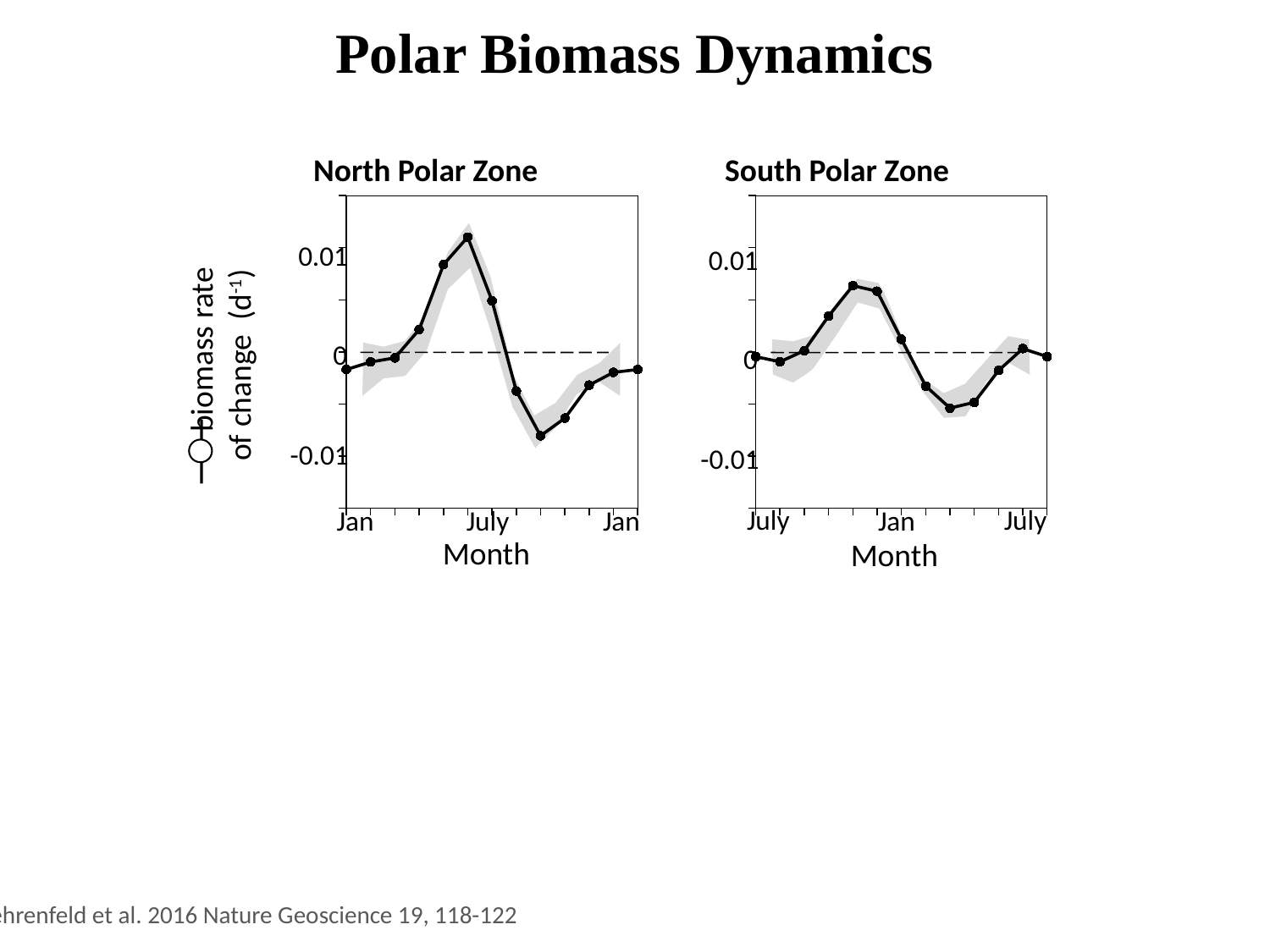
In the North Polar Zone chart, is the peak value of the line greater or less than 0.01? greater What kind of chart is the North Polar Zone chart? line chart Which chart has the higher peak value, North Polar Zone or South Polar Zone? North Polar Zone What is the highest value shown on the y-axis of the North Polar Zone chart? 0.01 In the South Polar Zone chart, is the lowest value of the line greater or less than -0.01? greater What is the x-axis label on both charts? Month In the North Polar Zone chart, is the lowest value of the line greater or less than 0? less In the North Polar Zone chart, does the line rise or fall between Jan and July? rise In the North Polar Zone chart, near which labelled month does the line reach its highest value? July What kind of chart is the South Polar Zone chart? line chart